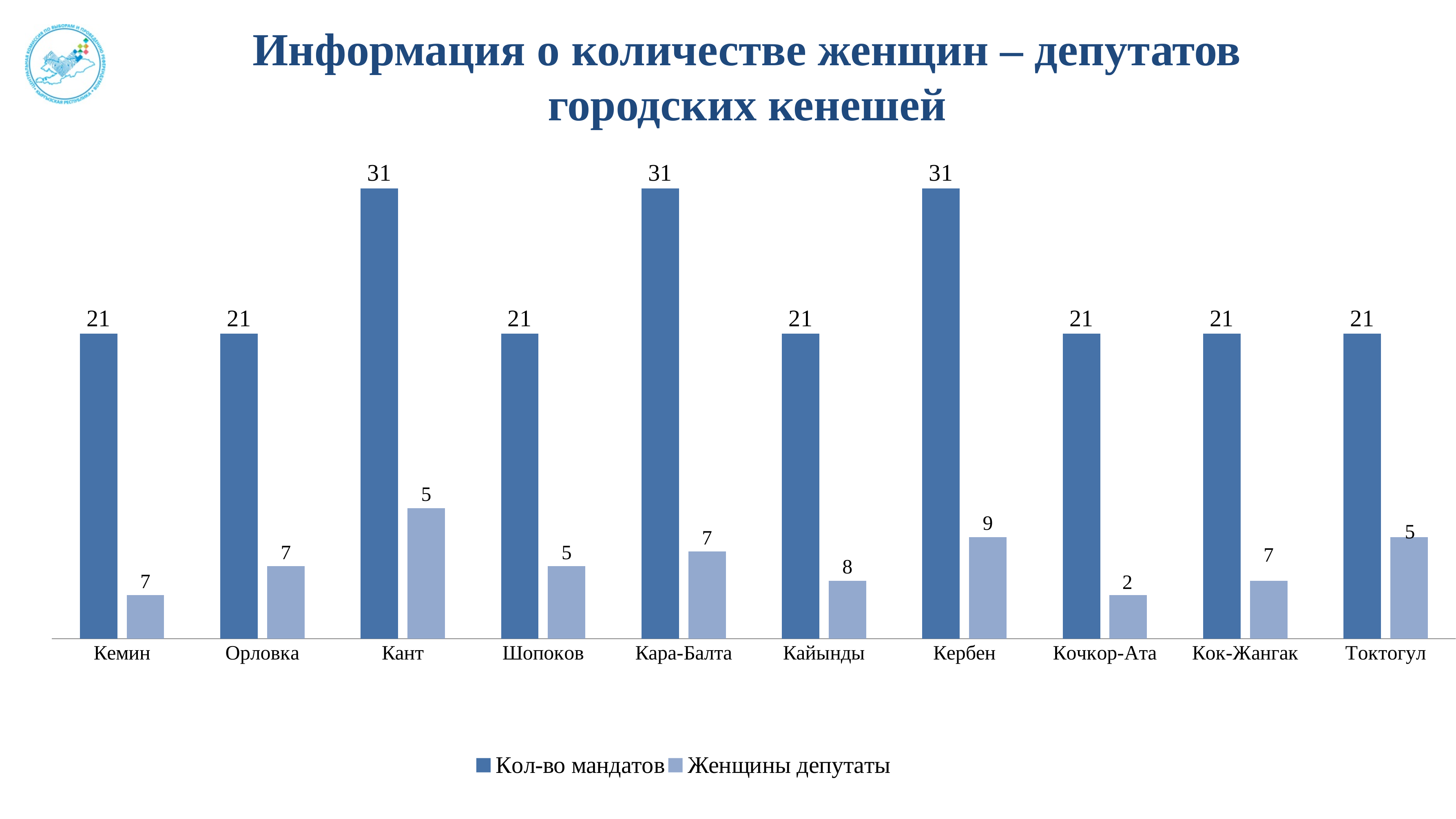
What is the difference between Кол-во мандатов and Женщины депутаты for Кайынды? 13 What is the value of Кол-во мандатов for Кант? 31 How many Женщины депутаты are shown for Кербен? 9 Which category has the highest value for Женщины депутаты? Кербен Which is larger: Женщины депутаты for Орловка or for Шопоков? Орловка How many categories are shown on the x axis? 10 What kind of chart is shown on the slide? Bar chart How many series does the legend list? 2 Which category has the lowest value for Женщины депутаты? Кочкор-Ата What is the value of Женщины депутаты for Кочкор-Ата? 2 What is the difference in Женщины депутаты between Кербен and Кочкор-Ата? 7 What is the title of the chart? Информация о количестве женщин – депутатов городских кенешей